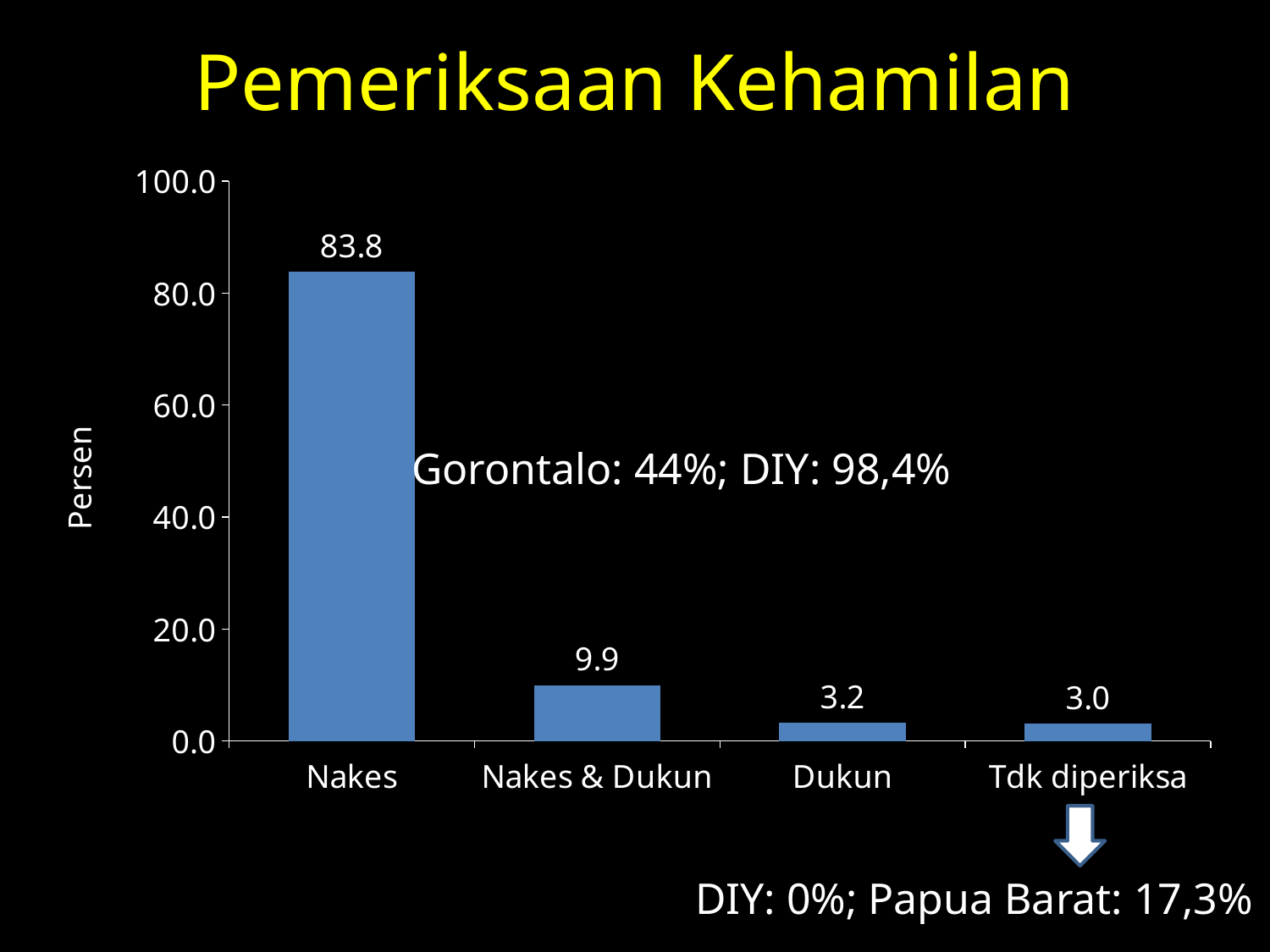
What is the value for Nakes? 83.8 What is the value for Dukun? 3.2 Is the value for Nakes greater or less than 80.0? greater What kind of chart is shown on the slide? bar chart What is the value for Tdk diperiksa? 3.0 What is the difference between the values for Dukun and Tdk diperiksa? 0.2 Which is larger, the value for Nakes & Dukun or the value for Dukun? Nakes & Dukun How many categories are shown on the x axis? 4 What is the value for Nakes & Dukun? 9.9 What is the difference between the values for Nakes and Nakes & Dukun? 73.9 Which category has the highest value? Nakes What is the label of the y axis? Persen